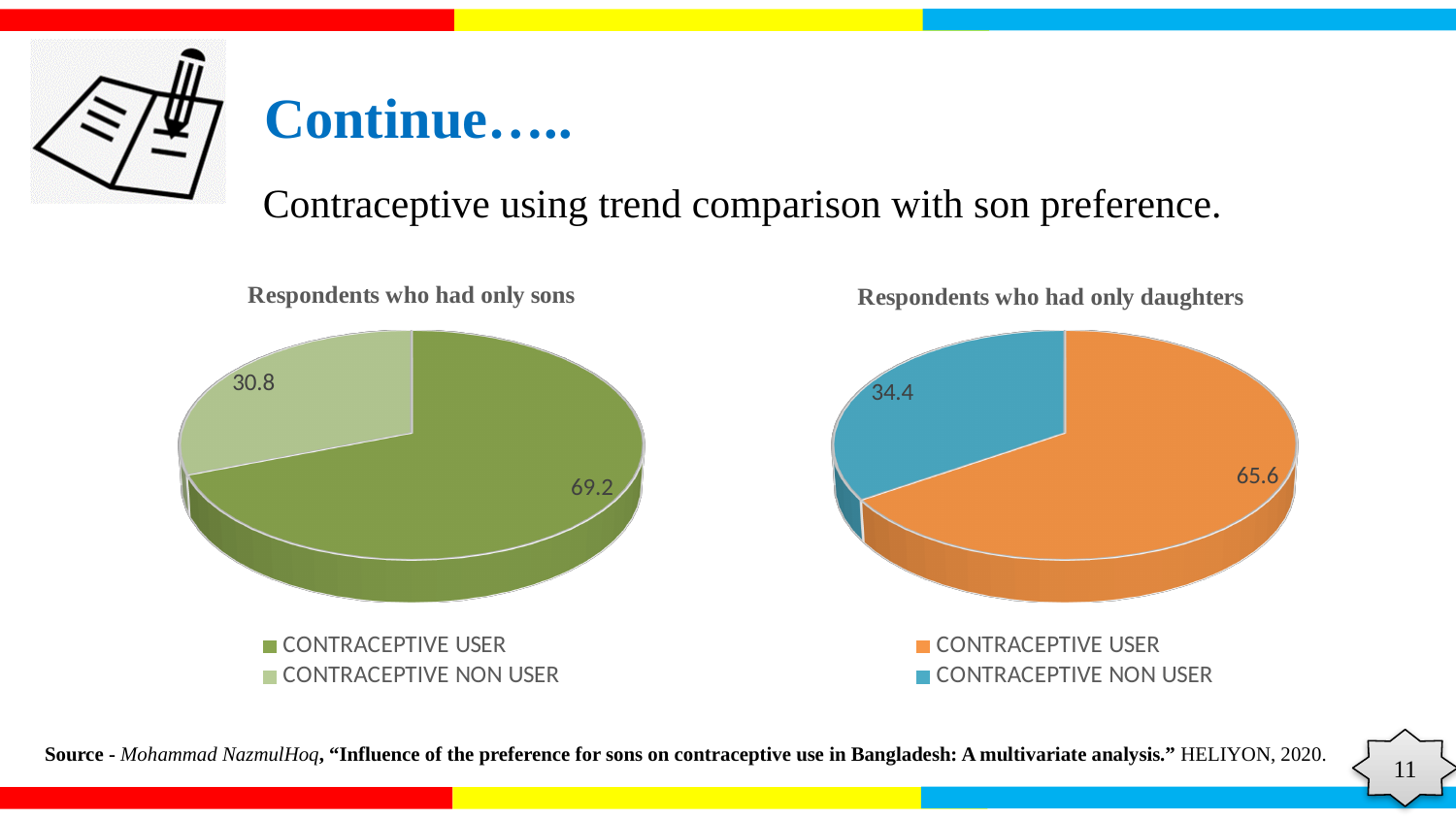
How many categories does the 'Respondents who had only daughters' chart show? 2 In the 'Respondents who had only sons' chart, what is the difference between the CONTRACEPTIVE USER and CONTRACEPTIVE NON USER values? 38.4 In the 'Respondents who had only sons' chart, what is the value for CONTRACEPTIVE USER? 69.2 In the 'Respondents who had only daughters' chart, which category has the smallest slice? CONTRACEPTIVE NON USER In the 'Respondents who had only sons' chart, which category has the largest slice? CONTRACEPTIVE USER In the 'Respondents who had only daughters' chart, what is the value for CONTRACEPTIVE NON USER? 34.4 Is the CONTRACEPTIVE USER value larger in the 'Respondents who had only sons' chart or the 'Respondents who had only daughters' chart? Respondents who had only sons In the 'Respondents who had only daughters' chart, what is the difference between the CONTRACEPTIVE USER and CONTRACEPTIVE NON USER values? 31.2 What type of chart is the 'Respondents who had only sons' chart? Pie chart In the 'Respondents who had only sons' chart, what is the value for CONTRACEPTIVE NON USER? 30.8 In the 'Respondents who had only daughters' chart, what is the value for CONTRACEPTIVE USER? 65.6 In the 'Respondents who had only daughters' chart, what colour is the CONTRACEPTIVE USER slice? Orange